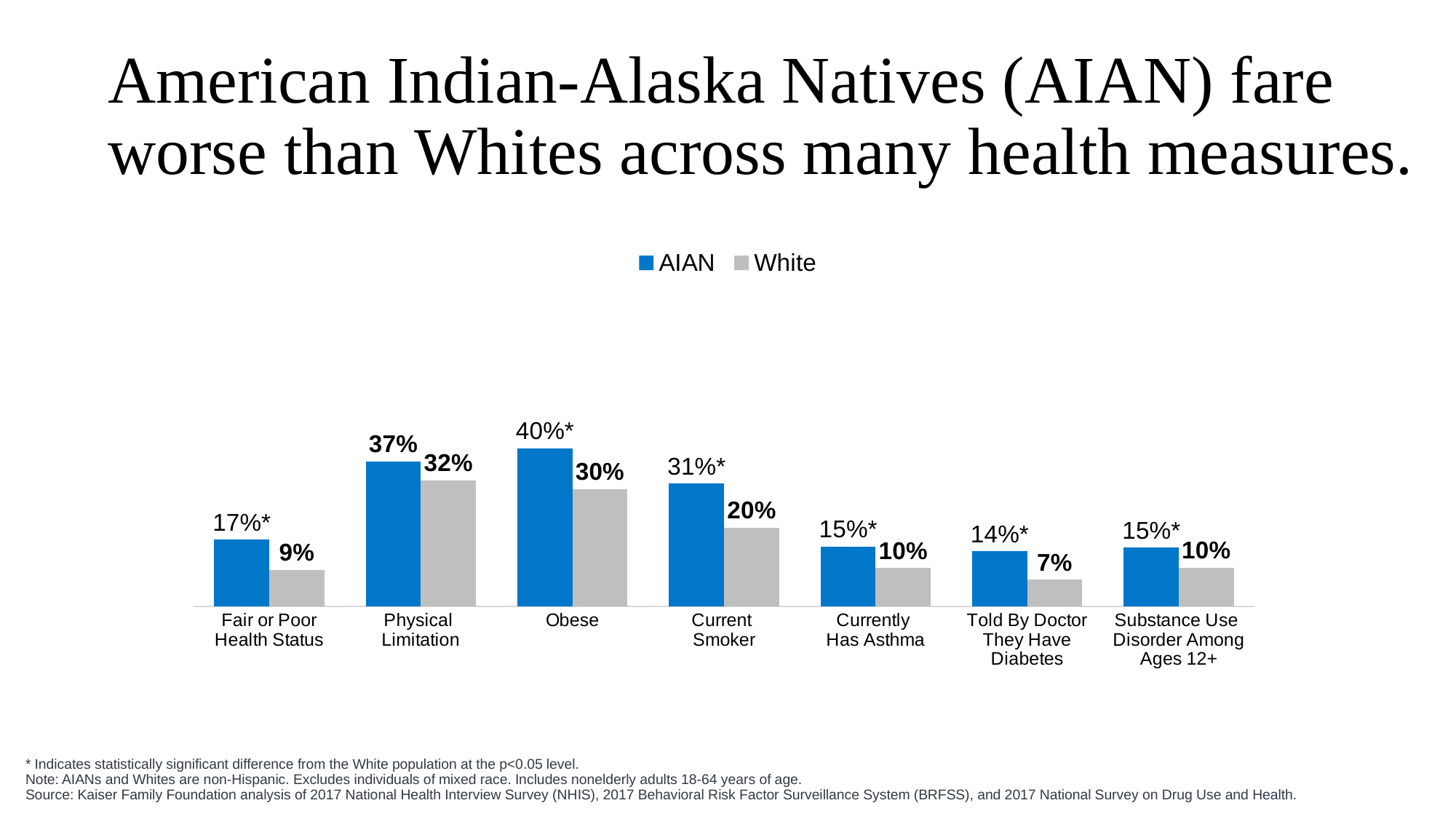
What is the AIAN value for Physical Limitation? 37% How many series does the legend list? 2 What is the White value for Current Smoker? 20% How many categories are shown on the x axis? 7 What kind of chart is shown on the slide? Bar chart Which category has the lowest White value? Told By Doctor They Have Diabetes What is the difference between the AIAN and White values for Current Smoker? 11% Which category has the highest AIAN value? Obese Which is larger for Physical Limitation, the AIAN value or the White value? AIAN What is the White value for Told By Doctor They Have Diabetes? 7% What is the AIAN value for Obese? 40% What is the difference between the AIAN and White values for Fair or Poor Health Status? 8%